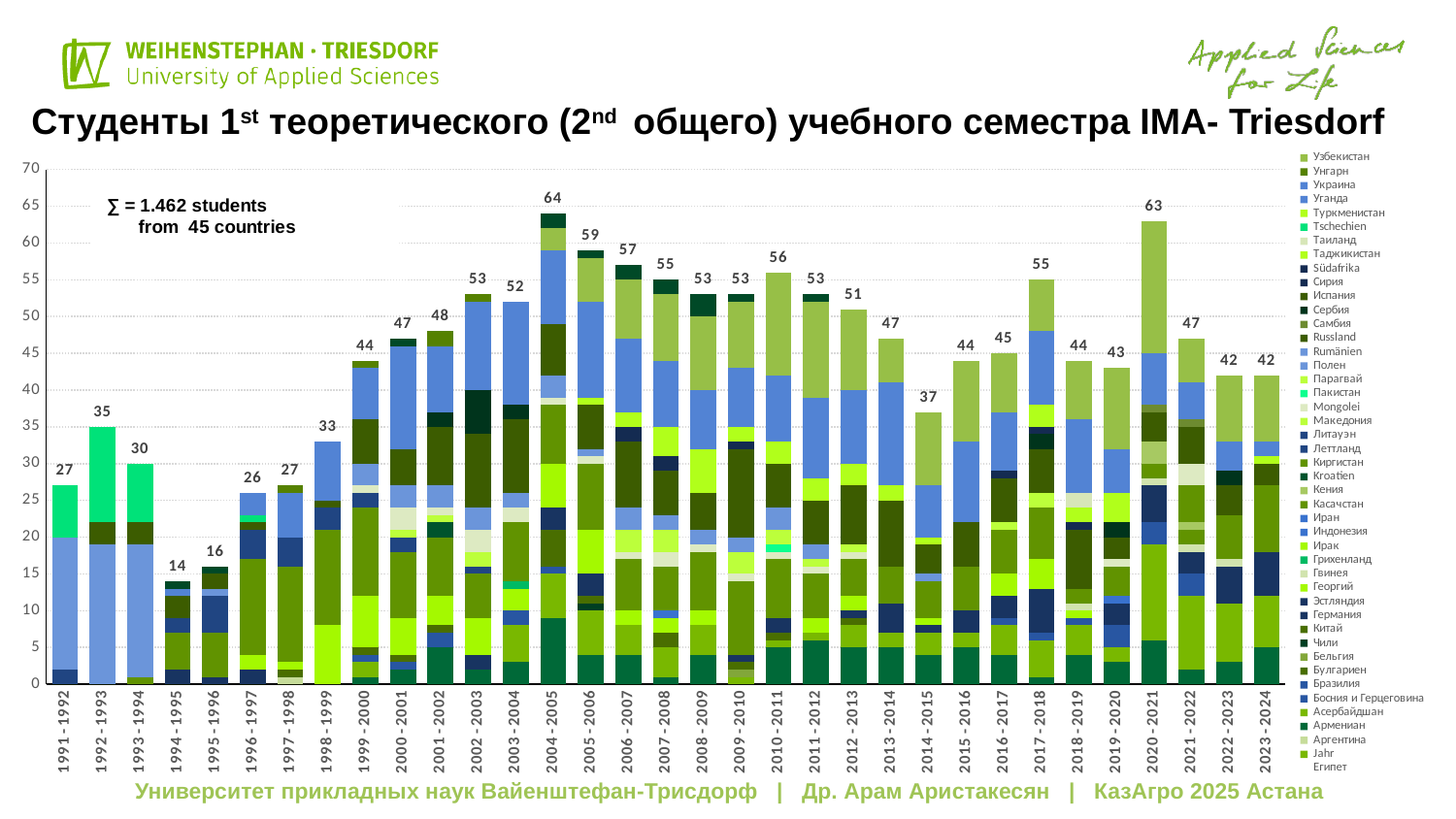
Which academic year has the highest total number of students? 2004 - 2005 What is the difference between the totals for 2004 - 2005 and 2020 - 2021? 1 According to the annotation on the chart, how many students in total and from how many countries are represented? 1.462 students from 45 countries What kind of chart is shown on the slide? Stacked bar chart How many academic years are shown on the x axis? 33 What is the total number of students shown for 2020 - 2021? 63 Which has a larger total, 2017 - 2018 or 2018 - 2019? 2017 - 2018 Which academic year has the lowest total number of students? 1994 - 1995 What is the total number of students shown for 2004 - 2005? 64 What is the difference between the totals for 1992 - 1993 and 1991 - 1992? 8 What is the total number of students shown for 2014 - 2015? 37 What is the total number of students shown for 1994 - 1995? 14